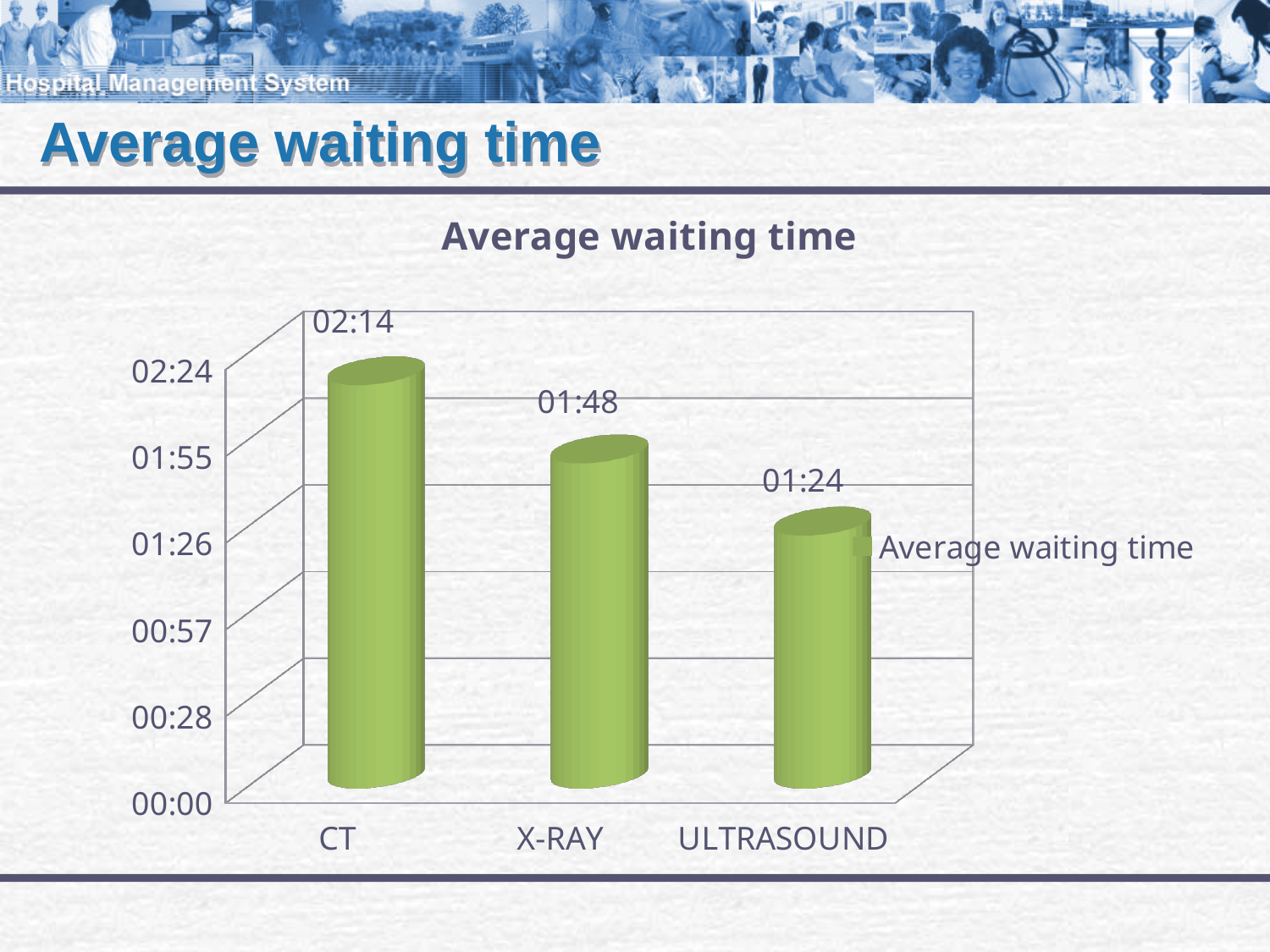
How many categories are shown on the x axis? 3 Which has a longer average waiting time, X-RAY or ULTRASOUND? X-RAY Is the value for CT greater or less than 01:55? greater Which category has the highest average waiting time? CT Do the values rise or fall from CT to ULTRASOUND along the x axis? fall What is the average waiting time for ULTRASOUND? 01:24 What is the average waiting time for CT? 02:14 What is the average waiting time for X-RAY? 01:48 What kind of chart is shown on the slide? bar chart What is the difference between the average waiting time for CT and for X-RAY? 00:26 Which category has the lowest average waiting time? ULTRASOUND How many series does the legend list? 1